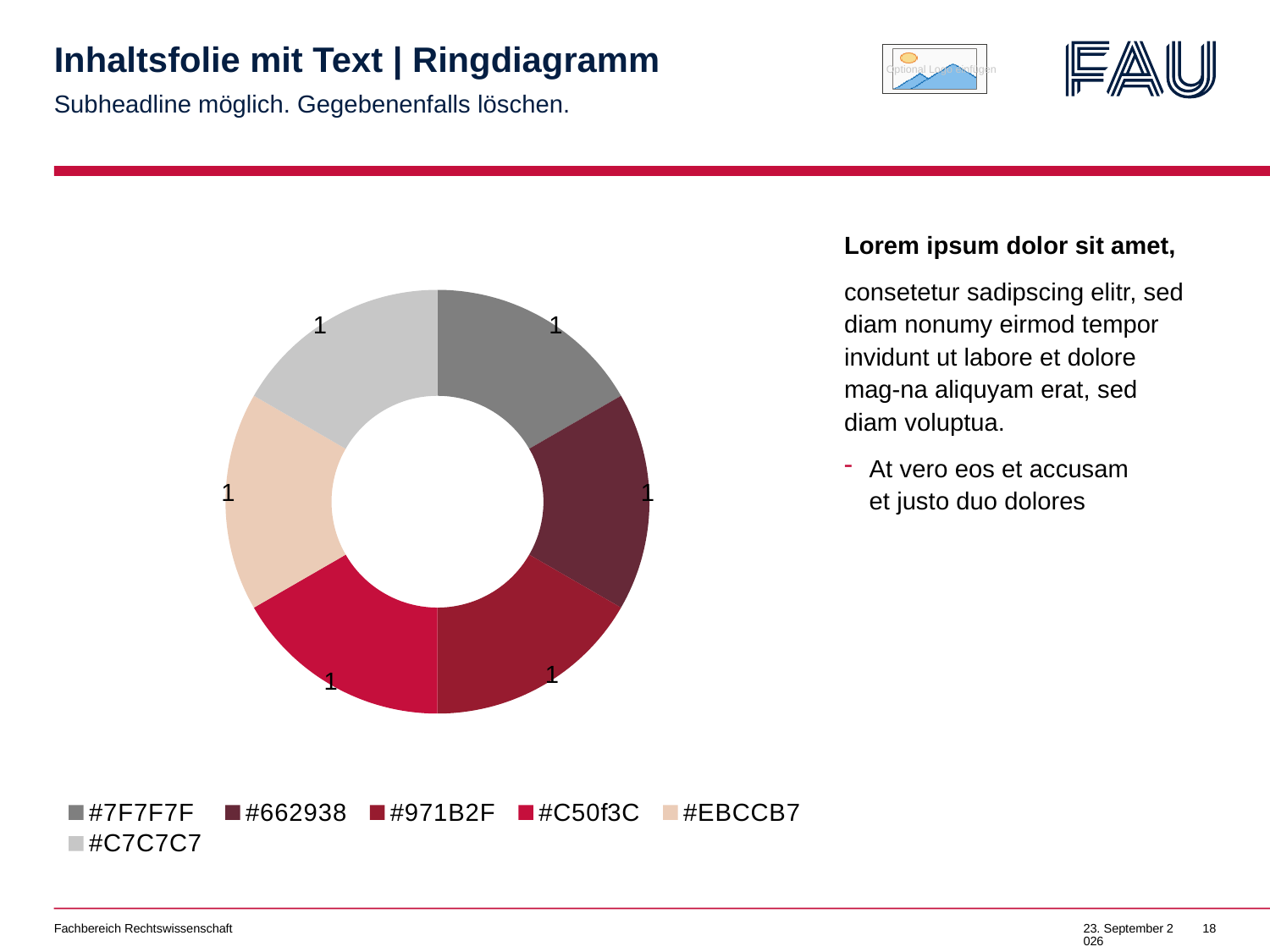
How many entries does the chart legend list? 6 Which legend entry is listed first? #7F7F7F What is the value of the #EBCCB7 segment? 1 How many segments does the doughnut chart have? 6 What is the difference between the values of the #971B2F and #C50f3C segments? 0 What is the value of the #662938 segment? 1 Which legend entry is listed last? #C7C7C7 What is the total of all segment values in the doughnut chart? 6 Is the value of the #C50f3C segment larger than, smaller than, or equal to the value of the #7F7F7F segment? equal What kind of chart is shown on the slide? doughnut chart What is the value of the #7F7F7F segment? 1 What is the value of the #C7C7C7 segment? 1